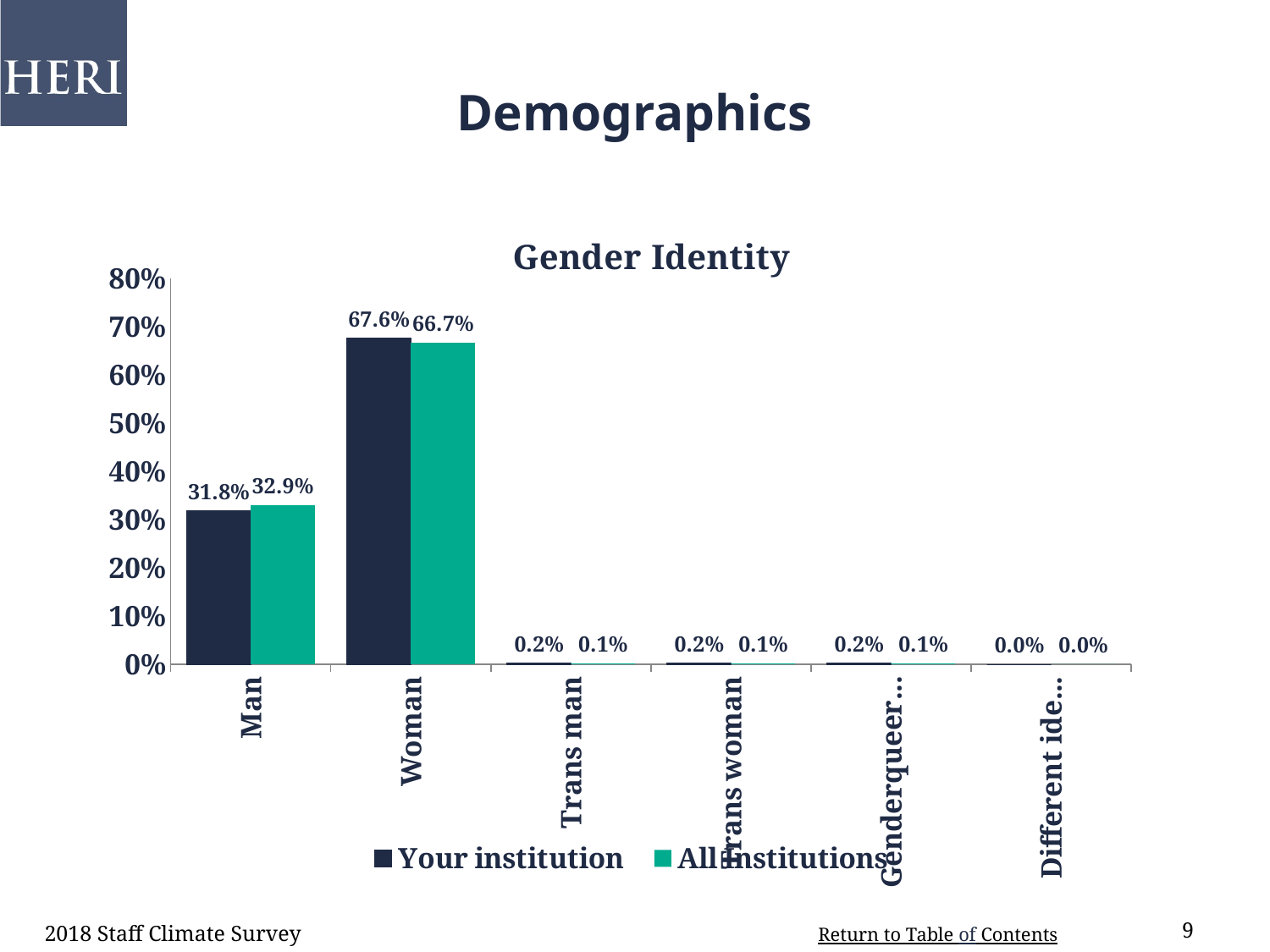
What is the value for Trans man in the Your institution series? 0.2% What is the difference between the Your institution and All institutions values for Man? 1.1% What is the value for Woman in the Your institution series? 67.6% Which category has the highest value in the Your institution series? Woman What kind of chart is shown on the slide? bar chart Which is larger for Woman: the Your institution value or the All institutions value? Your institution Is the Your institution value for Man greater or less than 40%? less How many series does the legend of the Gender Identity chart list? 2 How many categories are shown on the x axis of the Gender Identity chart? 6 What is the value for Trans woman in the All institutions series? 0.1% What is the value for Man in the All institutions series? 32.9% What is the title of the chart on the slide? Gender Identity